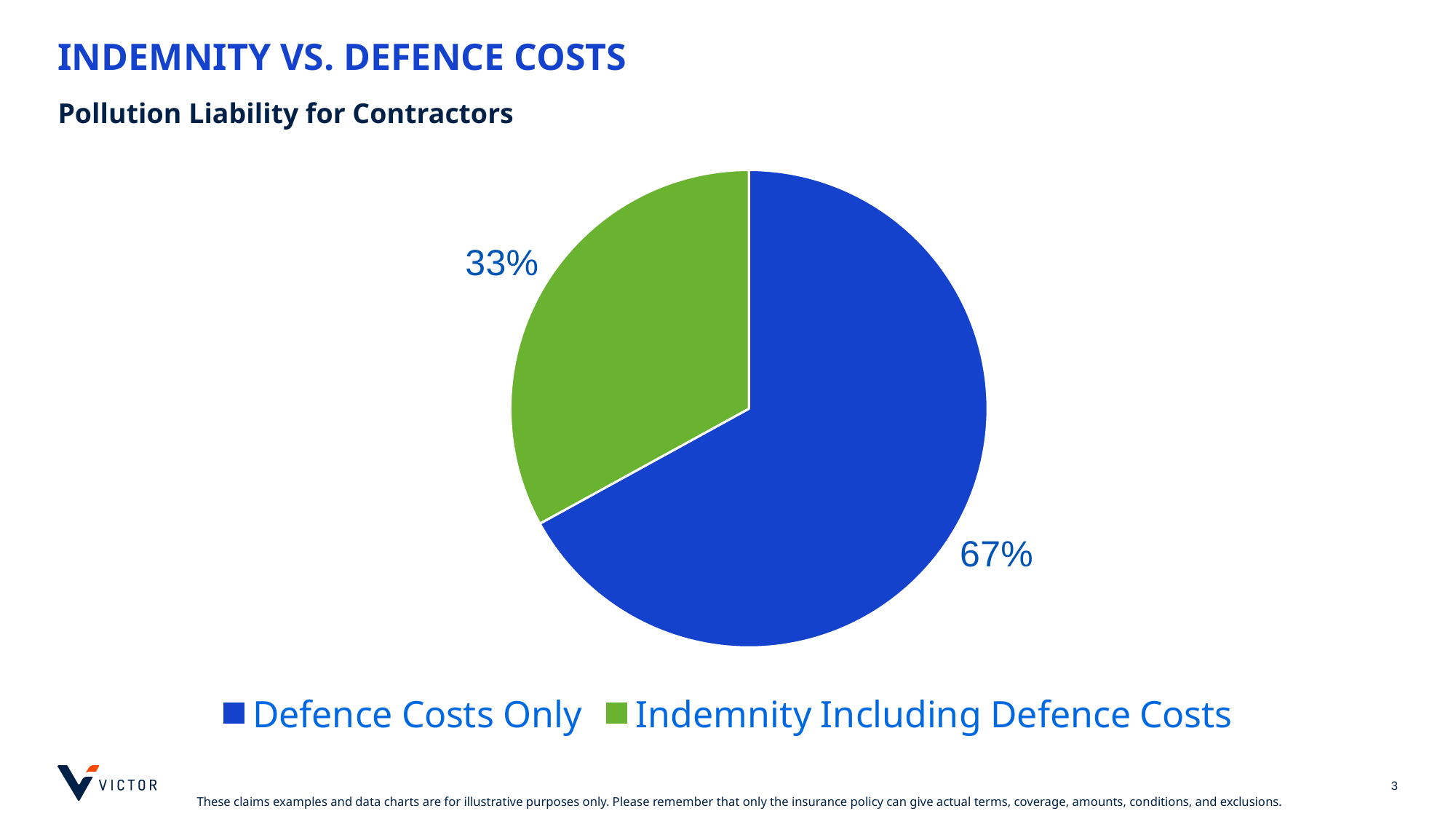
Which slice of the pie is the largest? Defence Costs Only How many entries does the legend list? 2 What colour is the Indemnity Including Defence Costs slice? Green What is the title of the slide containing the chart? INDEMNITY VS. DEFENCE COSTS How many slices does the pie chart have? 2 What share of the pie is Defence Costs Only? 67% What is the difference in percentage points between the Defence Costs Only slice and the Indemnity Including Defence Costs slice? 34 What share of the pie is Indemnity Including Defence Costs? 33% What kind of chart is shown on the slide? Pie chart Which is larger: Defence Costs Only or Indemnity Including Defence Costs? Defence Costs Only Which slice of the pie is the smallest? Indemnity Including Defence Costs